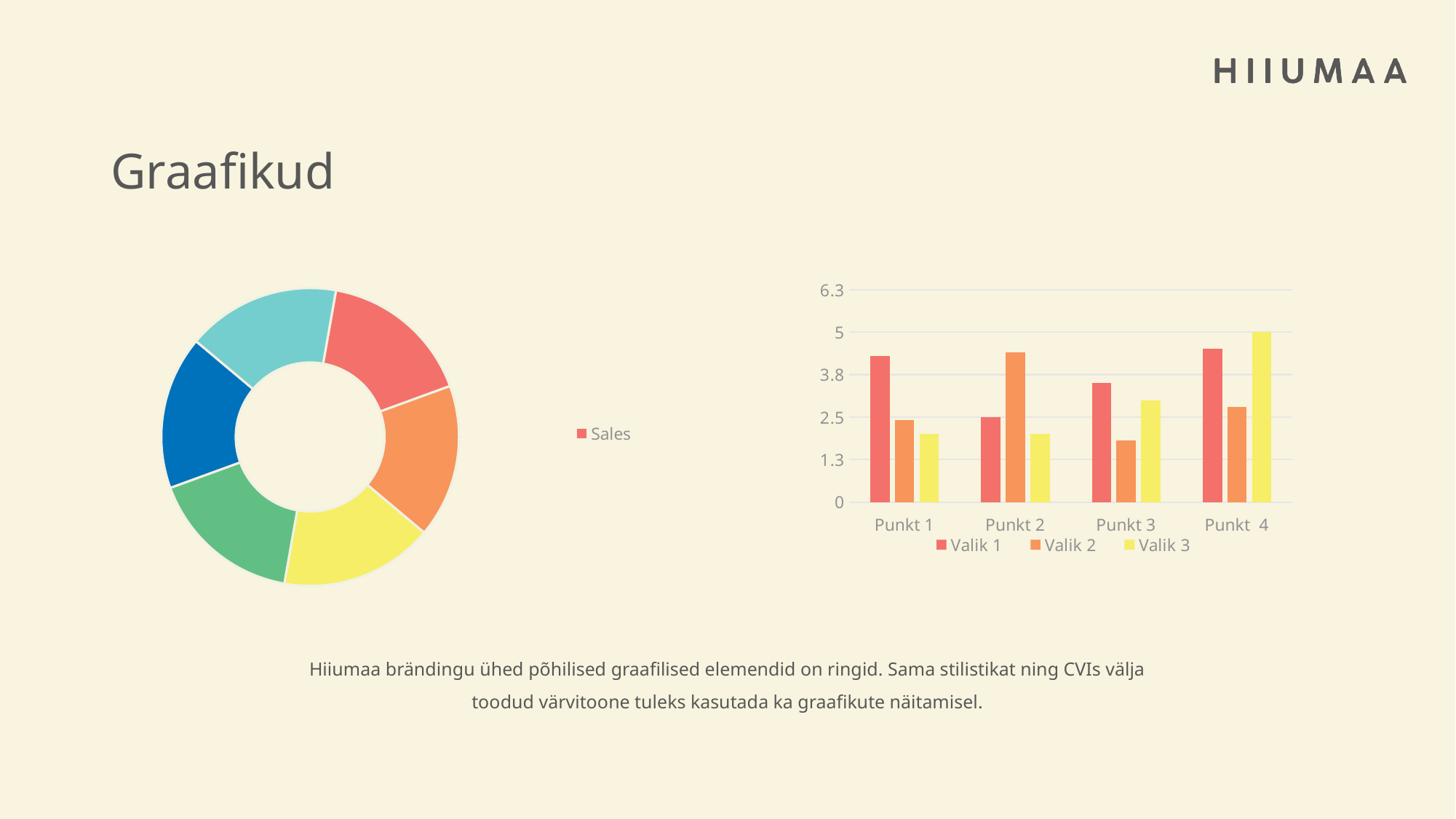
In the bar chart on the right, how many categories are shown on the x axis? 4 What kind of chart is the chart on the left of the slide? doughnut chart In the doughnut chart on the left, what is the legend entry? Sales In the bar chart on the right, which is larger: Valik 2 at Punkt 2 or Valik 2 at Punkt 3? Valik 2 at Punkt 2 In the bar chart on the right, is the value for Valik 3 at Punkt 1 greater or less than 2.5? less In the bar chart on the right, which series has the lowest value at Punkt 3? Valik 2 In the doughnut chart on the left, how many slices are there? 6 In the bar chart on the right, which series has the highest value at Punkt 2? Valik 2 What kind of chart is the chart on the right of the slide? bar chart In the bar chart on the right, how many series does the legend list? 3 In the bar chart on the right, is the value for Valik 1 at Punkt 1 greater or less than 3.8? greater In the bar chart on the right, which series has the highest value at Punkt 4? Valik 3